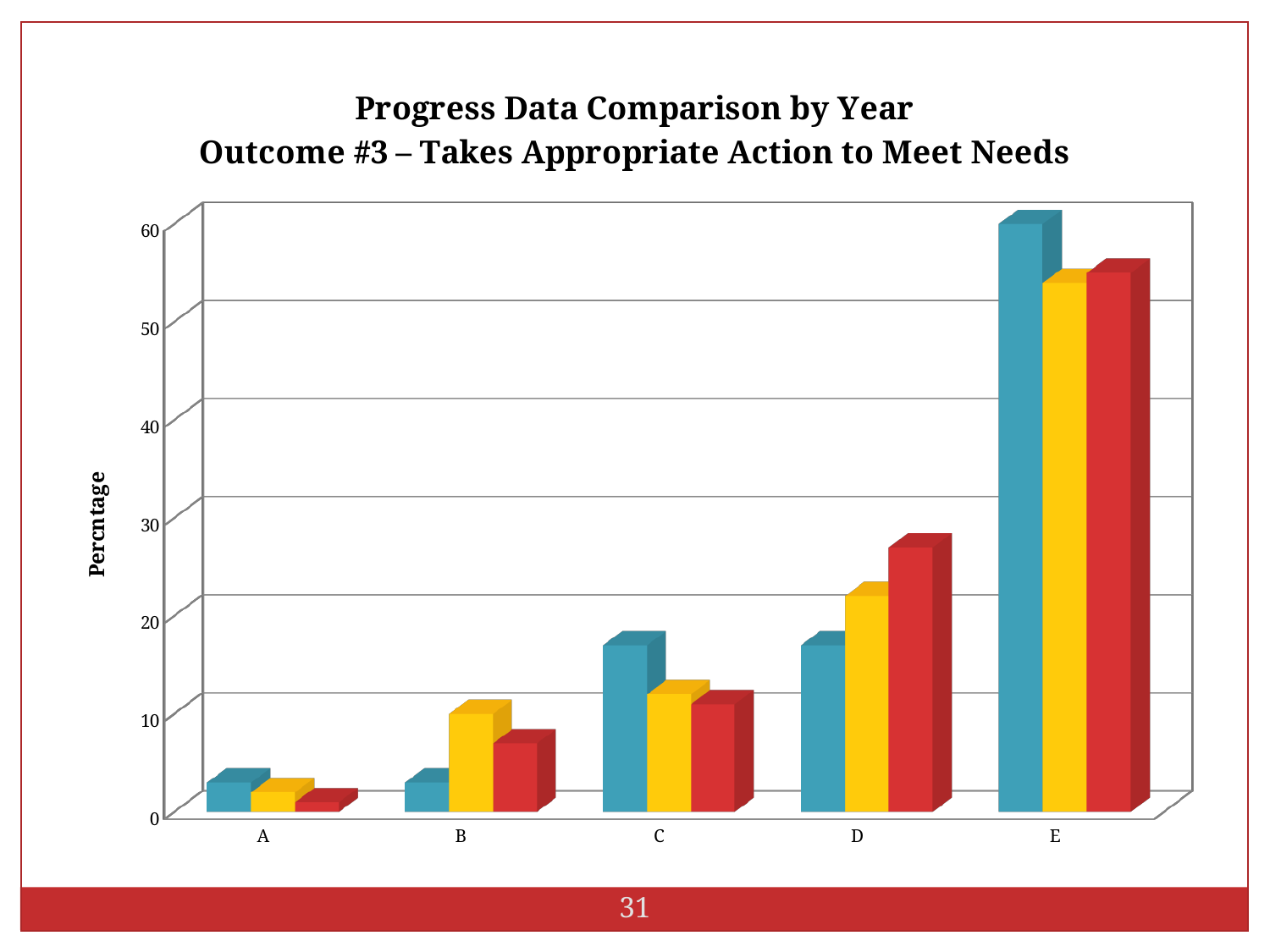
Do the red bars generally rise or fall from A to E? rise Is the value of the red bar for D greater or less than 20? greater Which category has the shortest yellow bar? A How many bars are plotted for each category? 3 Is the value of the blue bar for C greater or less than 20? less Which category has the shortest red bar? A Which category has the tallest blue bar? E How many categories are shown on the x axis? 5 What kind of chart is shown on the slide? bar chart In category D, which is larger, the red bar or the blue bar? red bar Is the value of the blue bar for E greater or less than 50? greater In category B, which is larger, the yellow bar or the blue bar? yellow bar